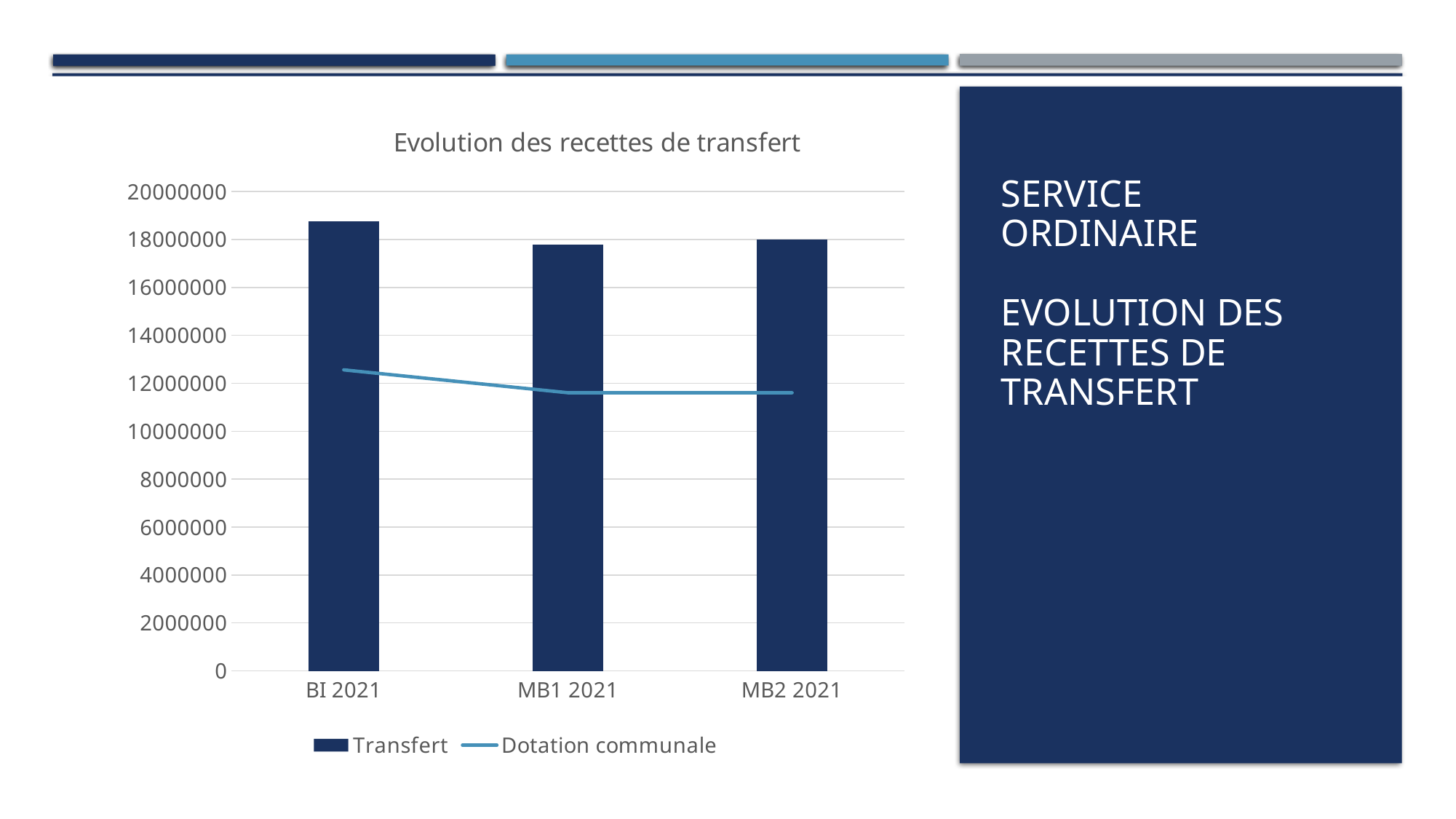
Is the Dotation communale value for BI 2021 greater or less than 12000000? greater Which series is shown as a line rather than bars? Dotation communale How many series does the chart legend list? 2 Which is larger, the Transfert value for BI 2021 or for MB1 2021? BI 2021 Which category has the highest Transfert value? BI 2021 Is the Transfert value for BI 2021 greater or less than 18000000? greater Is the Transfert value for MB1 2021 greater or less than 16000000? greater Does the Dotation communale line rise or fall from BI 2021 to MB1 2021? fall What kind of chart is used for the Transfert series? Bar chart What is the title of the chart? Evolution des recettes de transfert How many categories are shown on the x axis? 3